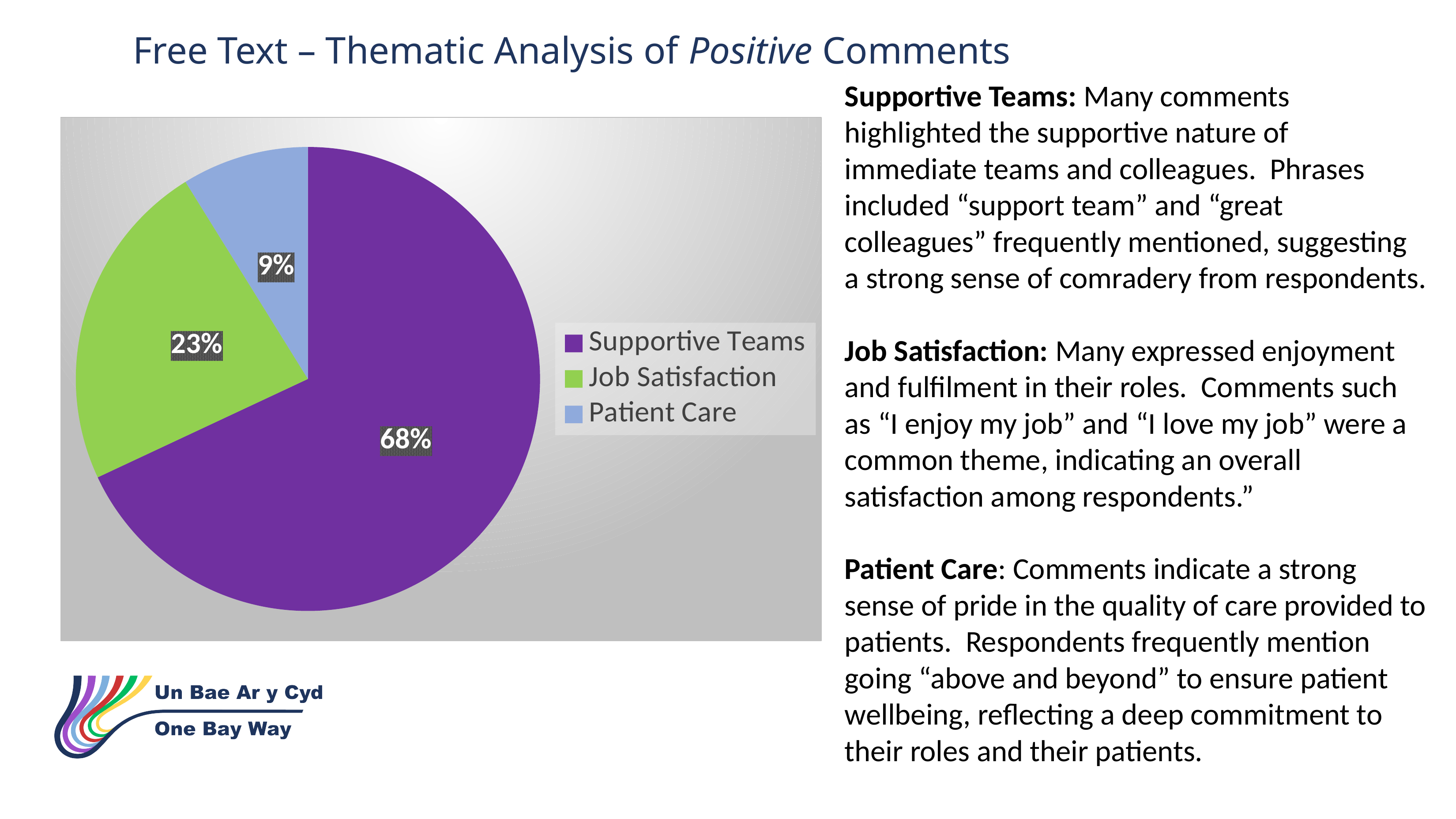
What colour is the Job Satisfaction slice? Green What is the title of the slide containing the chart? Free Text – Thematic Analysis of Positive Comments Which category has the smallest slice of the pie? Patient Care What is the difference in percentage points between Supportive Teams and Job Satisfaction? 45 What is the difference in percentage points between Job Satisfaction and Patient Care? 14 Which category has the largest slice of the pie? Supportive Teams Which is larger, the Job Satisfaction slice or the Patient Care slice? Job Satisfaction How many categories are shown in the pie chart? 3 What kind of chart is shown on the slide? Pie chart What share of the pie does Supportive Teams represent? 68% What share of the pie does Patient Care represent? 9% What share of the pie does Job Satisfaction represent? 23%